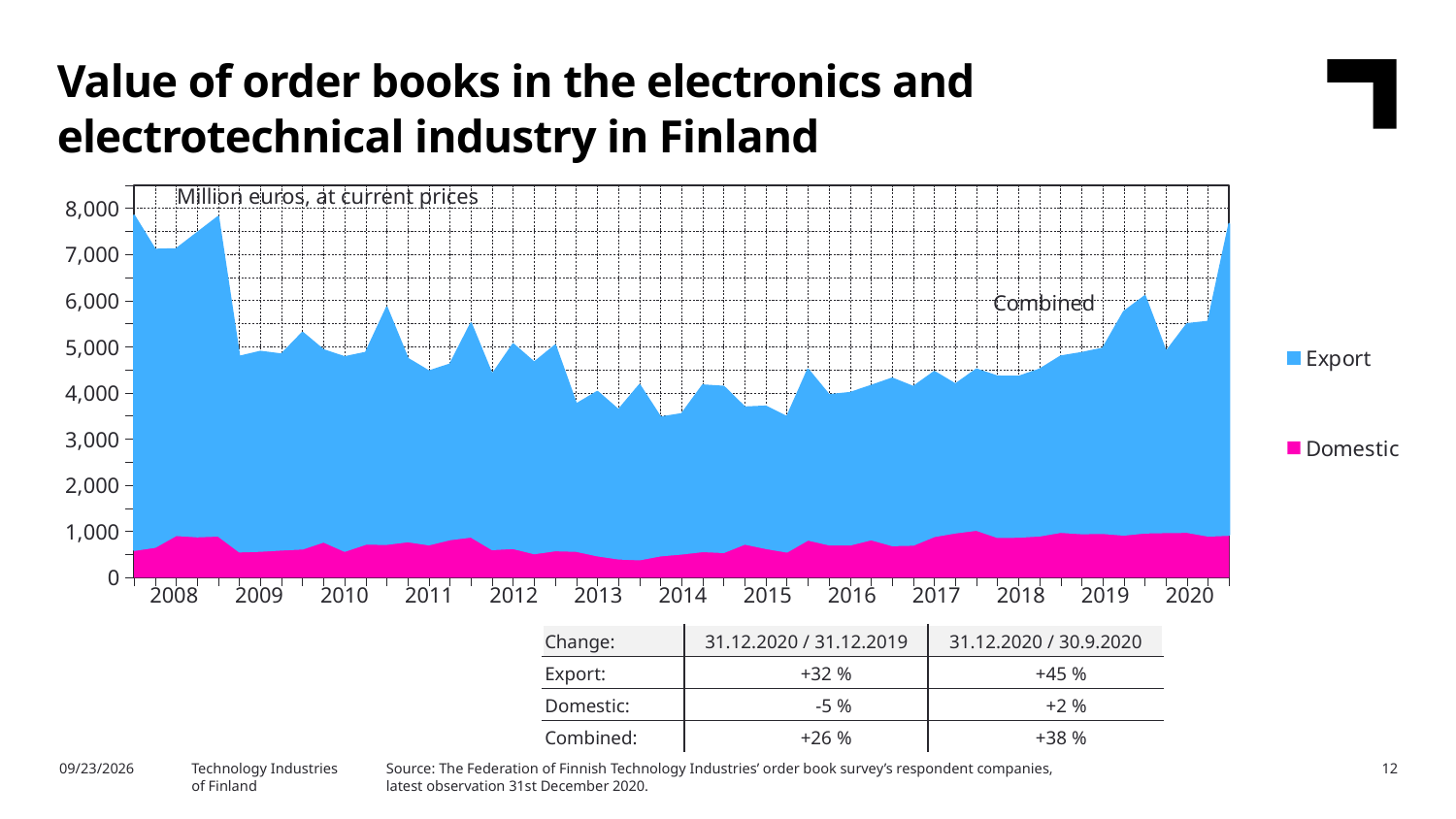
What unit is stated for the values in the chart? Million euros, at current prices Is the combined value at the end of 2020 greater or less than 7,000? greater How many series does the chart legend list? 2 Is the Domestic value during 2014 greater or less than 1,000? less How many years are labelled on the x axis of the chart? 13 Which series is larger throughout the chart, Export or Domestic? Export Does the combined value of order books rise or fall from 2008 to 2014? fall Is the combined value at the start of 2008 greater or less than 7,000? greater What kind of chart is shown on the slide? Stacked area chart Does the combined value of order books rise or fall from 2017 to the end of 2020? rise Which two series are listed in the chart legend? Export and Domestic